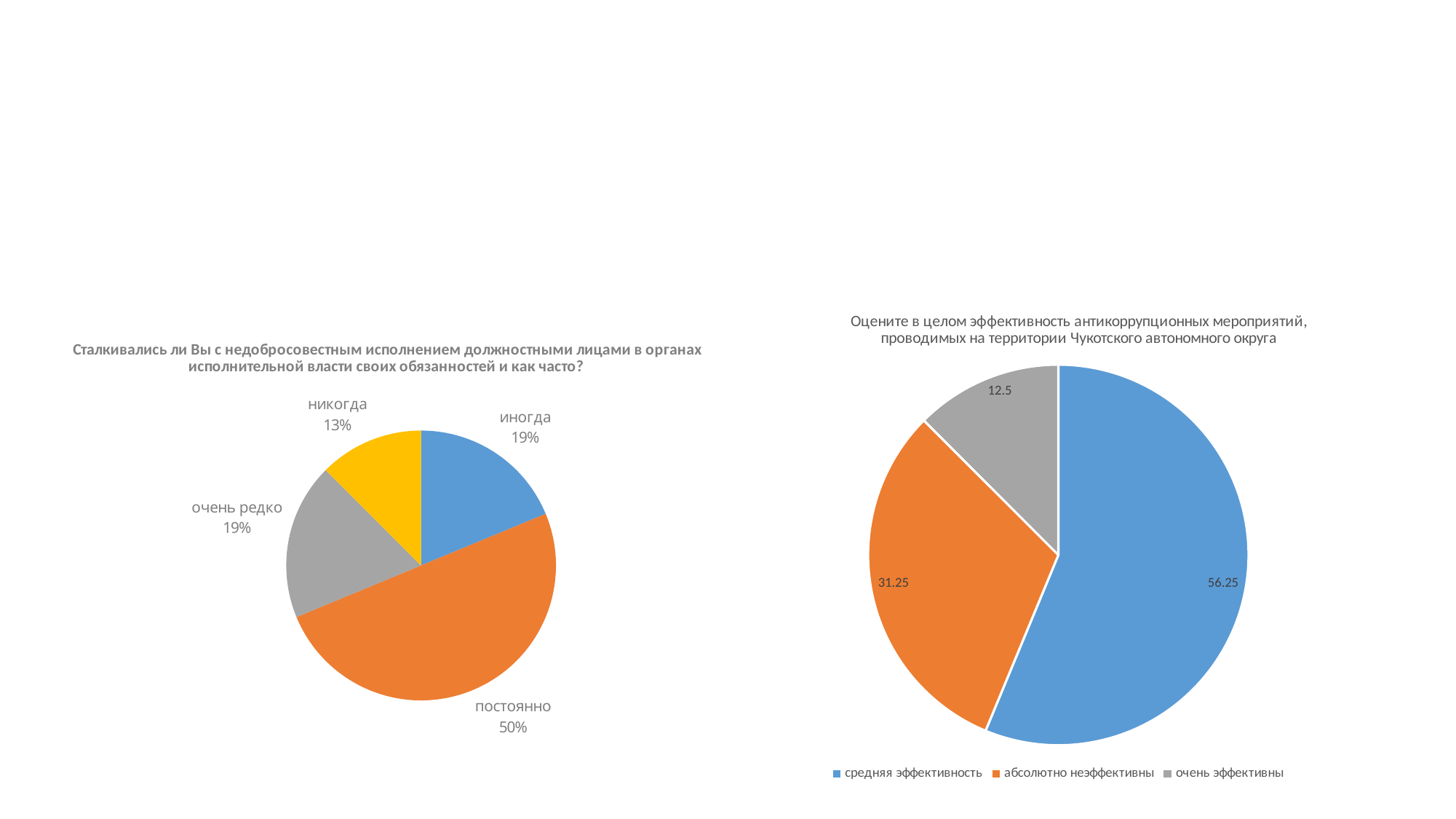
In the right pie chart, which is larger: "абсолютно неэффективны" or "очень эффективны"? абсолютно неэффективны In the right pie chart, what is the value for "средняя эффективность"? 56.25 How many slices does the left pie chart have? 4 In the right pie chart, what colour is the "абсолютно неэффективны" slice? orange In the right pie chart, what is the value for "очень эффективны"? 12.5 What kind of chart is the left chart on the slide? pie chart How many entries does the legend of the right pie chart list? 3 In the left pie chart, what is the difference between the shares for "постоянно" and "иногда"? 31% In the left pie chart, what is the share for "никогда"? 13% In the left pie chart, which category has the smallest slice? никогда In the left pie chart, what is the share for "постоянно"? 50% In the left pie chart, which category has the largest slice? постоянно